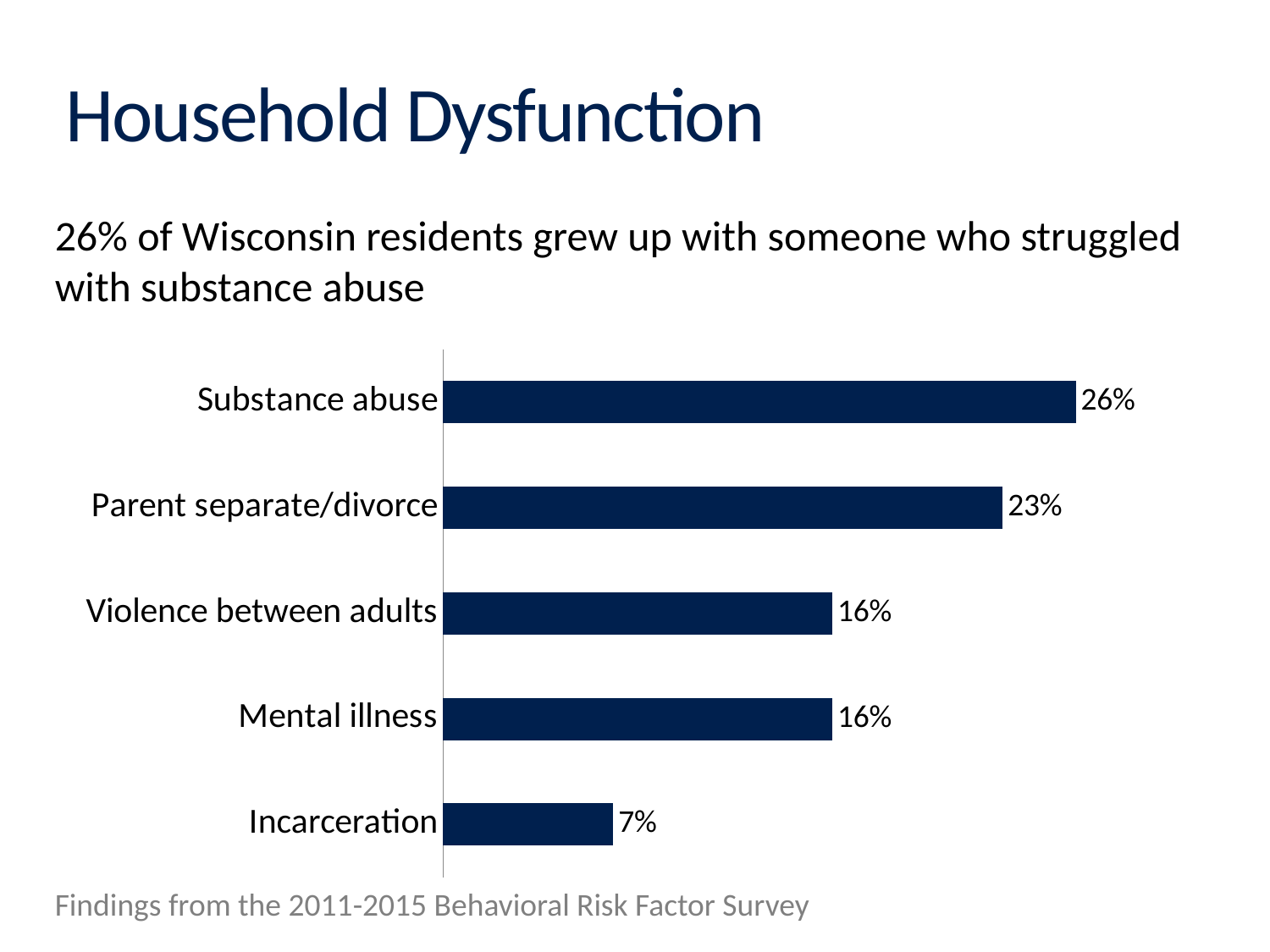
Which two categories have the same value? Violence between adults and Mental illness What is the value for Parent separate/divorce? 23% What is the value for Incarceration? 7% What is the difference between the values for Substance abuse and Parent separate/divorce? 3% Which category has the lowest value? Incarceration Which category has the highest value? Substance abuse What kind of chart is shown on the slide? Bar chart Which is larger, the value for Parent separate/divorce or the value for Mental illness? Parent separate/divorce What is the difference between the values for Violence between adults and Incarceration? 9% How many categories are shown in the chart? 5 What is the value for Substance abuse? 26% What is the value for Mental illness? 16%